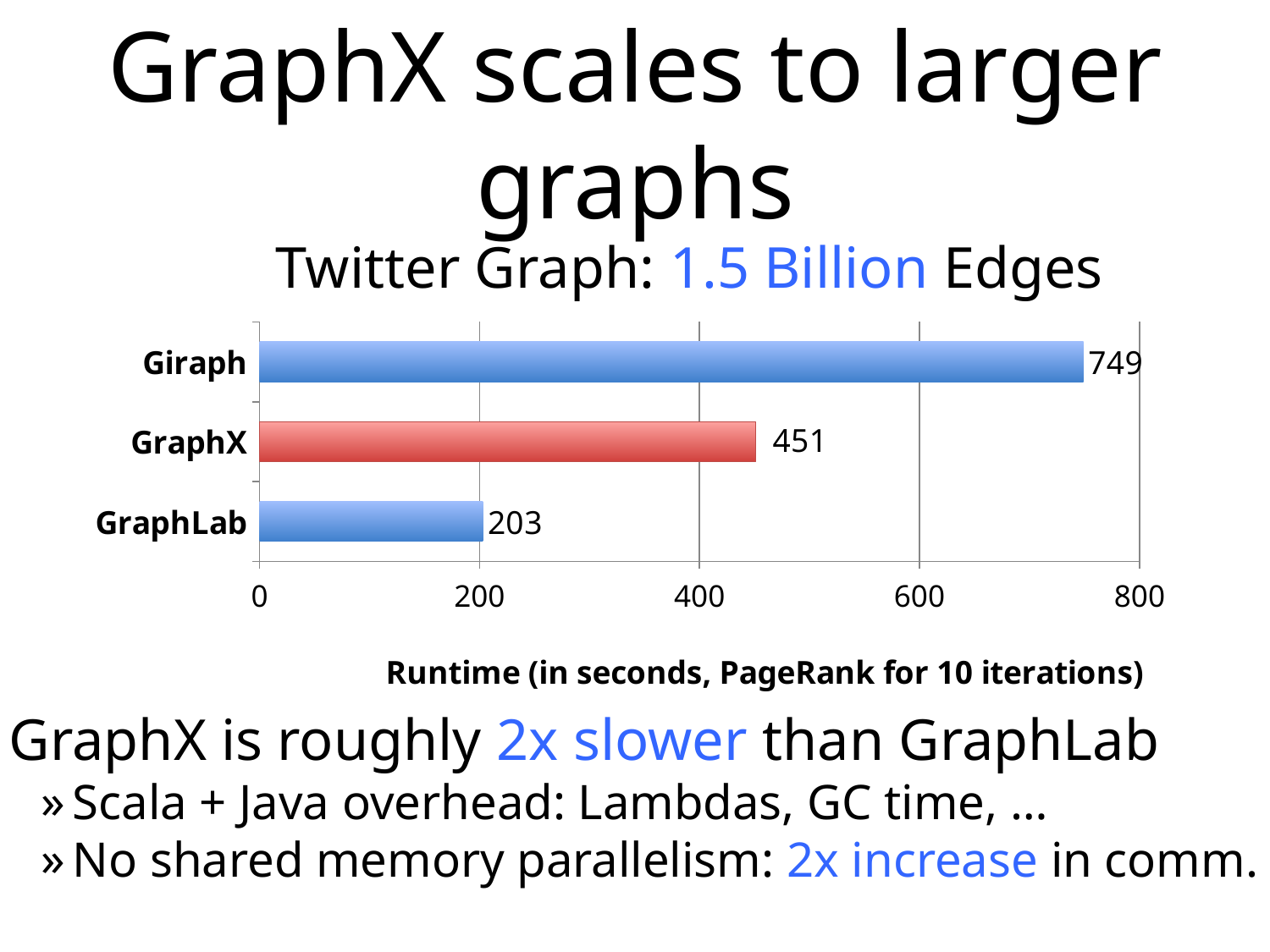
Which system has the lowest runtime? GraphLab What is the runtime for GraphX? 451 Which system has the highest runtime? Giraph What is the difference in runtime between Giraph and GraphX? 298 What is the difference in runtime between GraphX and GraphLab? 248 What is the runtime for GraphLab? 203 Is the runtime for GraphX greater or less than 400? greater Which has a larger runtime, GraphX or GraphLab? GraphX What is the label on the horizontal axis of the chart? Runtime (in seconds, PageRank for 10 iterations) What kind of chart is shown on the slide? bar chart How many systems are compared in the chart? 3 What is the runtime for Giraph? 749